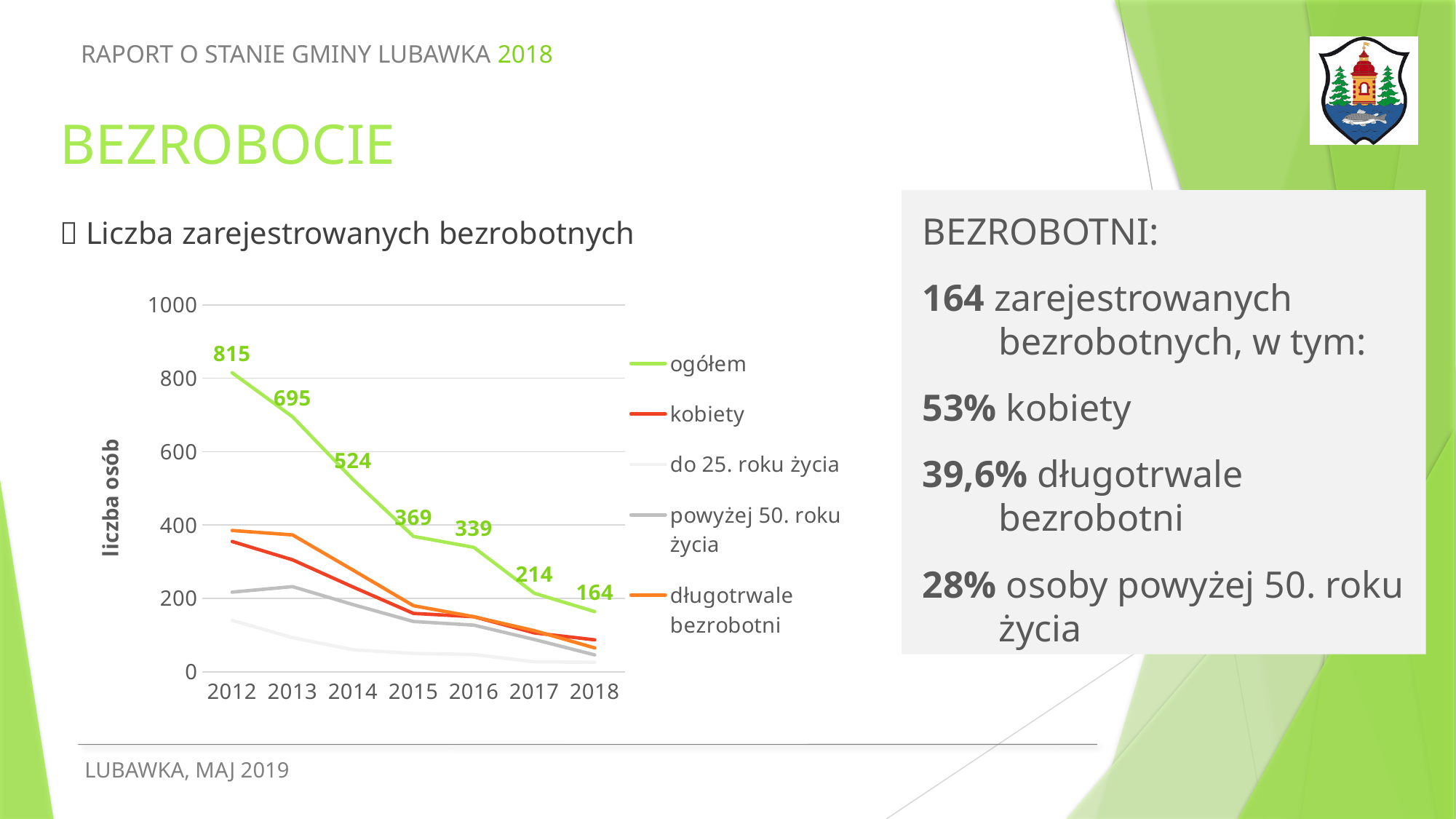
Is the value for kobiety in 2012 greater or less than 400? less In which year is the ogółem series at its lowest? 2018 What is the value of the ogółem series in 2012? 815 How many series does the chart legend list? 5 What kind of chart is shown on the slide? line chart What is the difference between the ogółem values for 2013 and 2014? 171 In which year is the ogółem series at its highest? 2012 What is the value of the ogółem series in 2018? 164 Is the value for długotrwale bezrobotni in 2013 greater or less than 200? greater How many years are shown on the x axis of the chart? 7 By how much did the ogółem value fall between 2012 and 2018? 651 Which year has the larger ogółem value, 2015 or 2016? 2015